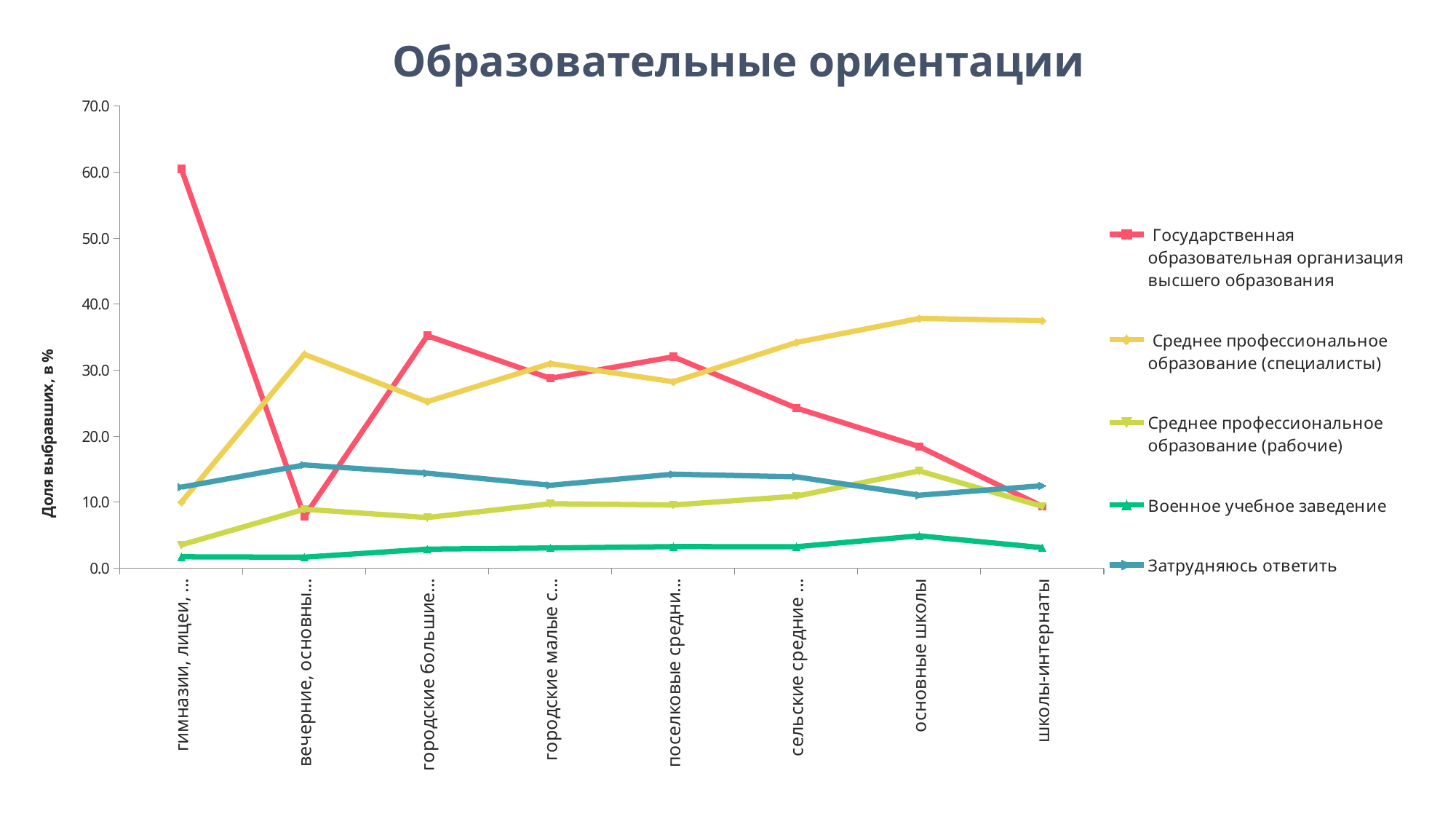
How many categories are plotted along the x axis? 8 Is the value for 'Среднее профессиональное образование (специалисты)' at 'школы-интернаты' greater or less than 30? greater What kind of chart is shown on the slide? line chart Which series has the lowest value at 'основные школы'? Военное учебное заведение How many series does the legend list? 5 Is the value for 'Военное учебное заведение' at 'школы-интернаты' greater or less than 10? less Is the value for 'Государственная образовательная организация высшего образования' at 'основные школы' greater or less than 20? less What is the title of the chart? Образовательные ориентации At 'основные школы', which is larger: 'Среднее профессиональное образование (рабочие)' or 'Затрудняюсь ответить'? Среднее профессиональное образование (рабочие) Does the 'Государственная образовательная организация высшего образования' line rise or fall from 'основные школы' to 'школы-интернаты'? fall What is the label of the vertical axis? Доля выбравших, в % Which series has the highest value at 'школы-интернаты'? Среднее профессиональное образование (специалисты)